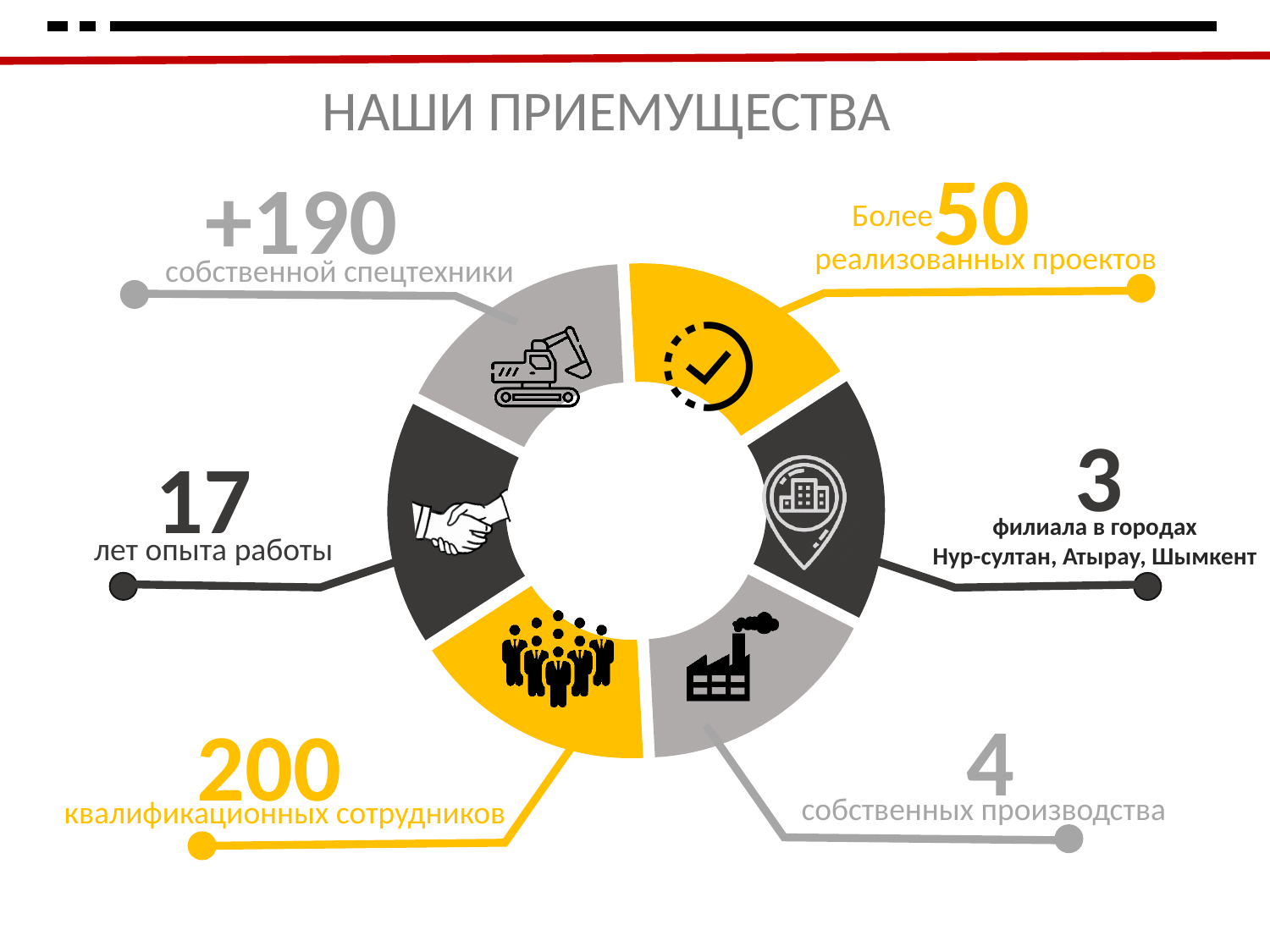
What number is shown for "собственной спецтехники" (own special equipment)? +190 How many segments does the ring diagram have? 6 What is the difference between the number of qualified employees (200) and the years of work experience (17)? 183 What is the title of the slide? НАШИ ПРИЕМУЩЕСТВА In which cities are the branches located according to the slide? Нур-султан, Атырау, Шымкент What number is shown for "лет опыта работы" (years of work experience)? 17 How many "реализованных проектов" (completed projects) does the slide state? Более 50 Which is larger: the number of qualified employees (квалификационных сотрудников) or the years of work experience (лет опыта работы)? квалификационных сотрудников What number is shown for "собственных производства" (own production facilities)? 4 What number is shown for "квалификационных сотрудников" (qualified employees)? 200 How many "филиала" (branches) does the slide state? 3